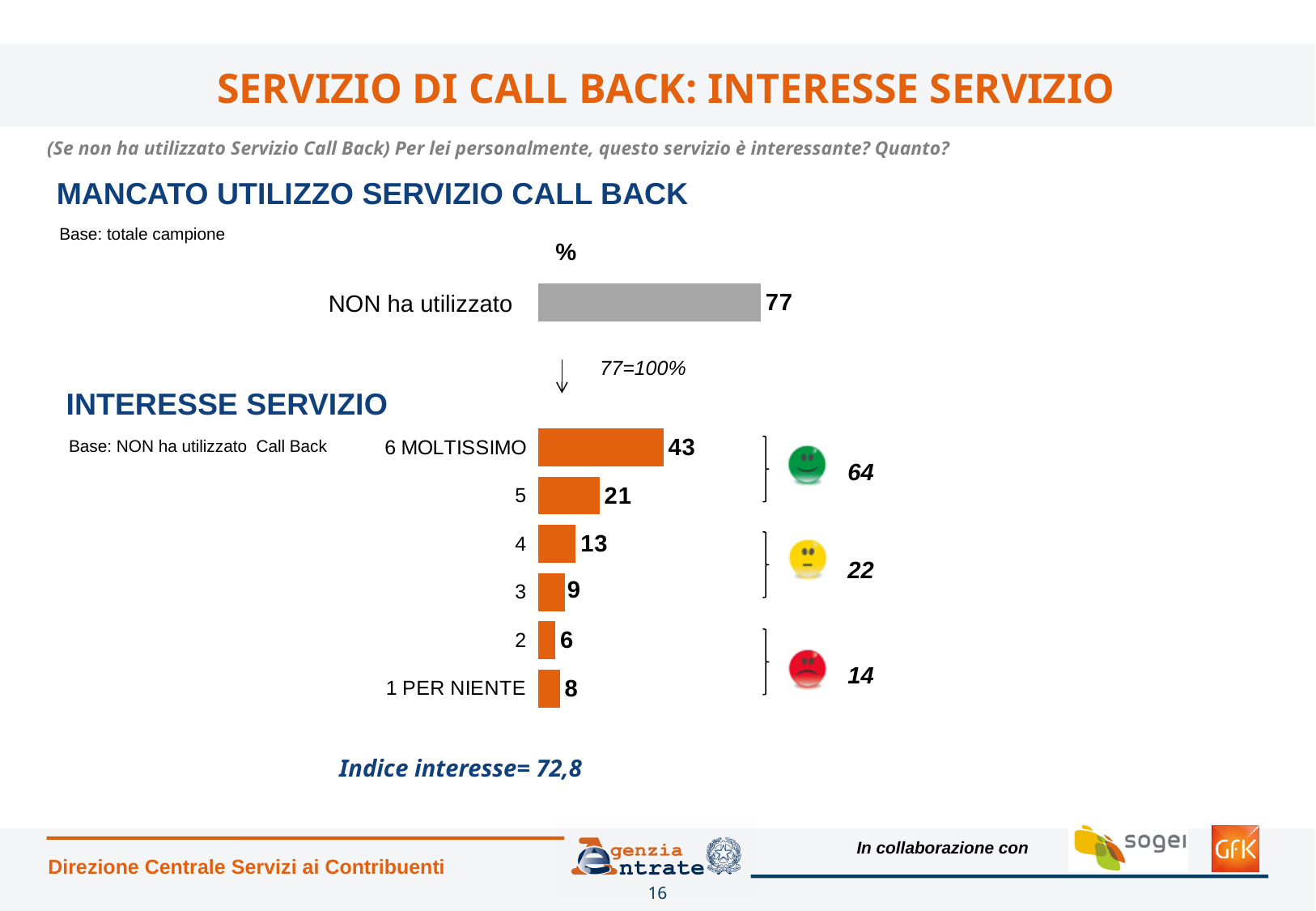
In the INTERESSE SERVIZIO chart, what is the combined value shown next to the green smiley for categories 6 and 5? 64 In the INTERESSE SERVIZIO chart, what is the value for category 4? 13 In the MANCATO UTILIZZO SERVIZIO CALL BACK chart, what is the value for NON ha utilizzato? 77 In the INTERESSE SERVIZIO chart, what is the value for 1 PER NIENTE? 8 How many categories are shown in the INTERESSE SERVIZIO chart? 6 In the INTERESSE SERVIZIO chart, which category has the highest value? 6 MOLTISSIMO In the INTERESSE SERVIZIO chart, what is the value for 6 MOLTISSIMO? 43 In the INTERESSE SERVIZIO chart, which is larger, the value for 3 or the value for 1 PER NIENTE? 3 What is the Indice interesse shown below the INTERESSE SERVIZIO chart? 72,8 What kind of chart is the INTERESSE SERVIZIO chart? bar chart In the INTERESSE SERVIZIO chart, what is the difference between the values for 6 MOLTISSIMO and 5? 22 In the INTERESSE SERVIZIO chart, which category has the lowest value? 2